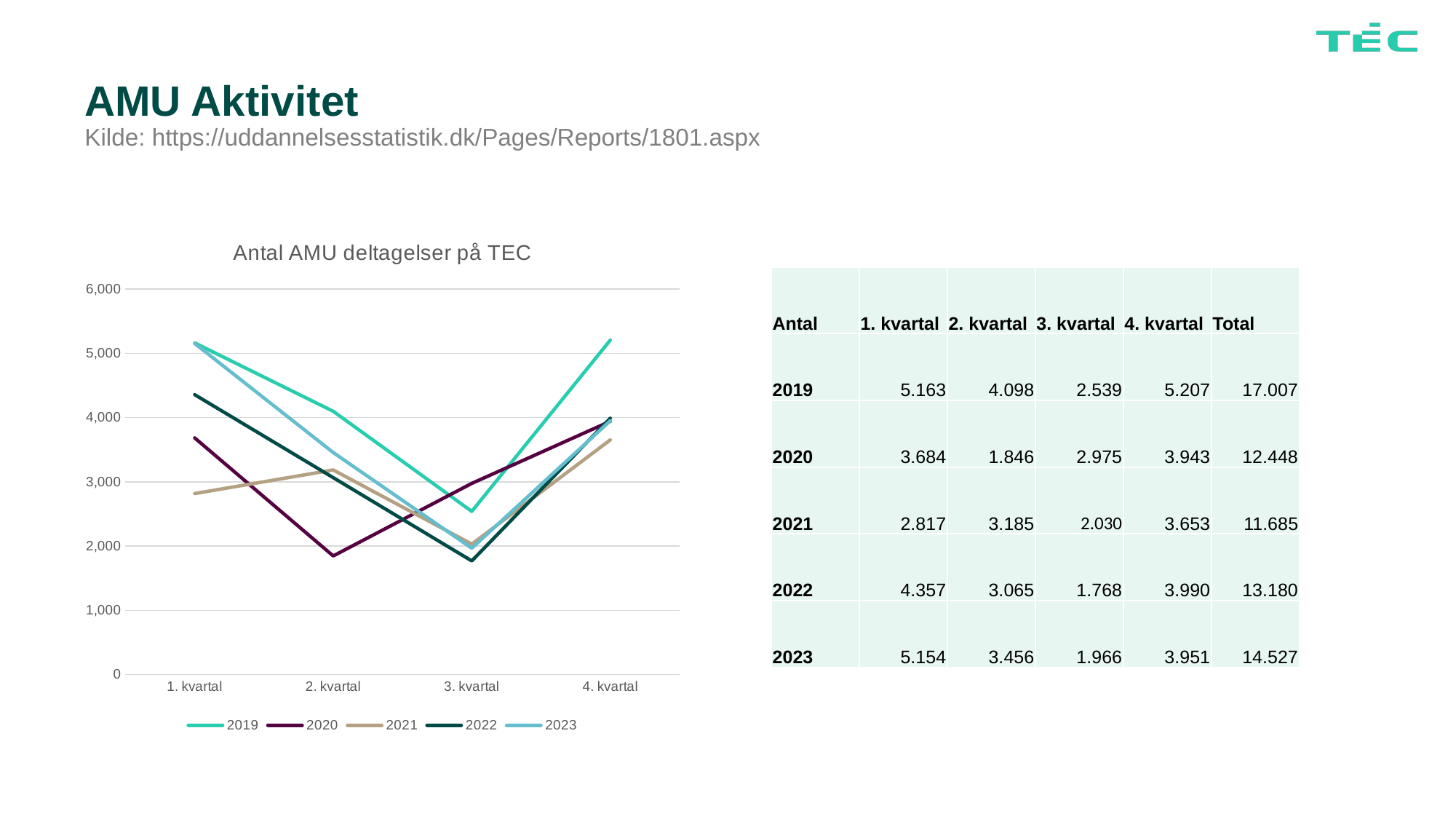
How many series does the legend of the chart list? 5 Is the value for 2023 in 1. kvartal greater or less than 5,000? greater What is the value for 2022 in 3. kvartal? 1.768 How many categories are shown on the x axis of the chart? 4 What is the value for 2020 in 2. kvartal? 1.846 What kind of chart is "Antal AMU deltagelser på TEC"? line chart Which quarter has the highest value for the 2019 series? 4. kvartal What is the difference between the 2019 and 2020 values in 1. kvartal? 1.479 What is the value for 2019 in 1. kvartal? 5.163 Does the 2020 series rise or fall from 3. kvartal to 4. kvartal? rise Which quarter has the lowest value for the 2021 series? 3. kvartal Which is larger in 2. kvartal, the value for 2021 or the value for 2022? 2021